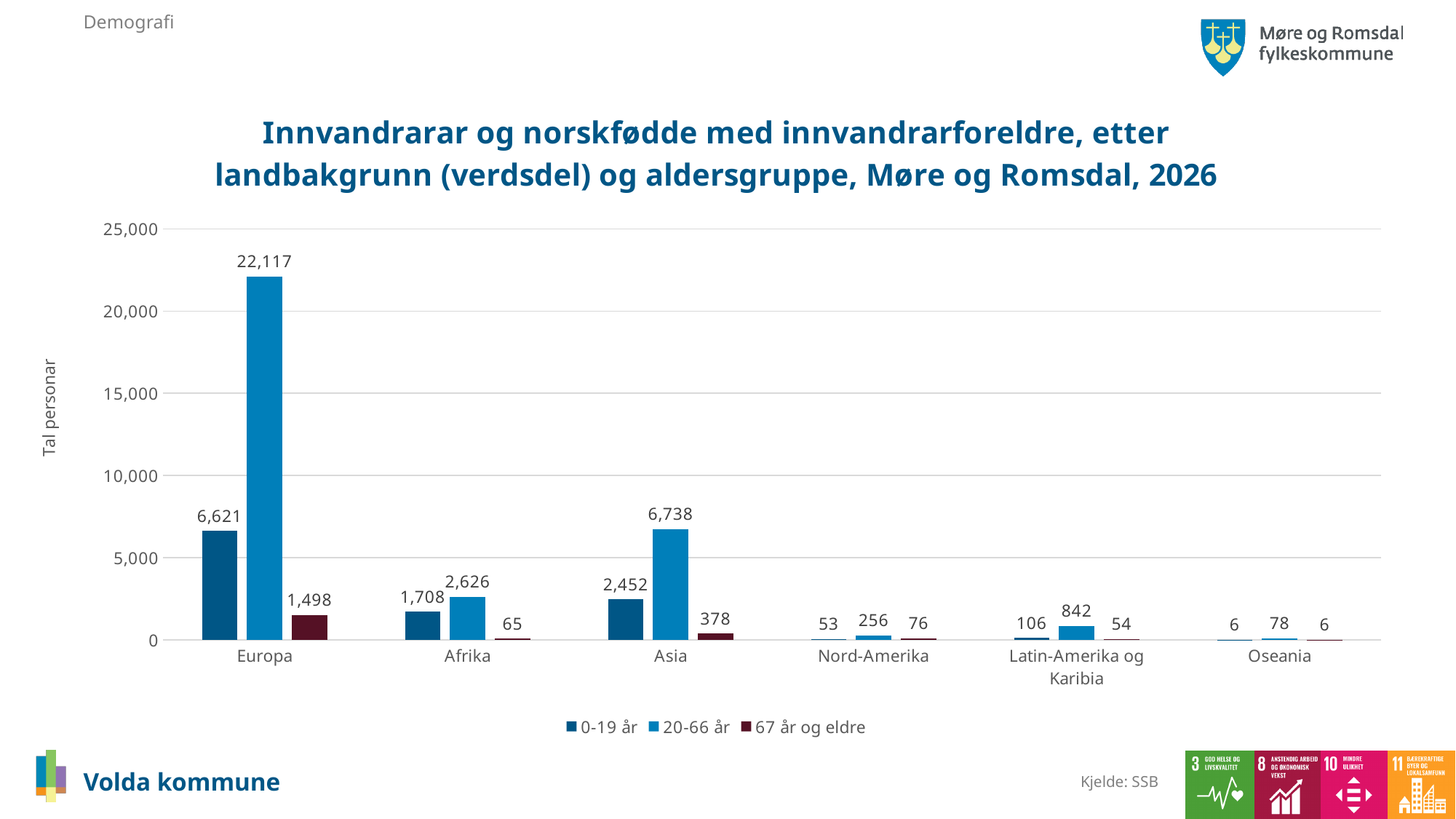
Which is larger: the 20-66 år value for Afrika or the 20-66 år value for Latin-Amerika og Karibia? Afrika What is the value for the 20-66 år series for Europa? 22,117 What is the difference between the 0-19 år values for Asia and Afrika? 744 What is the value for the 0-19 år series for Latin-Amerika og Karibia? 106 What is the label of the y axis? Tal personar What is the value for the 67 år og eldre series for Asia? 378 What kind of chart is shown on the slide? bar chart How many series does the legend list? 3 Is the 0-19 år value for Europa greater or less than 5,000? greater Which region has the highest value in the 20-66 år series? Europa How many regions are shown on the x axis? 6 Which region has the lowest value in the 0-19 år series? Oseania